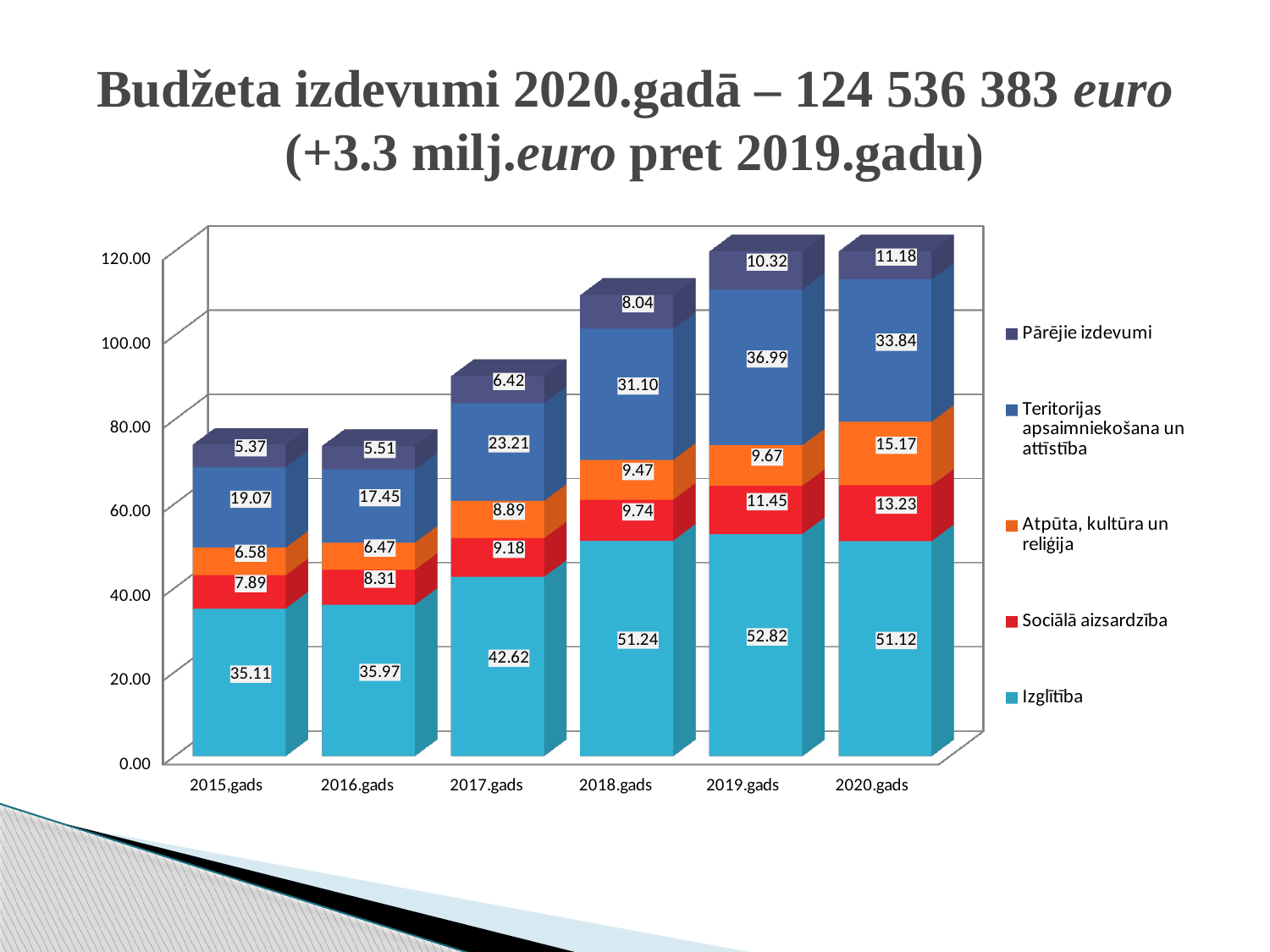
What is the total of the stacked bar for 2017.gads? 90.32 What kind of chart is shown on the slide? Stacked bar chart What is the value for Izglītība in 2018.gads? 51.24 What is the value for Atpūta, kultūra un reliģija in 2020.gads? 15.17 Does the Teritorijas apsaimniekošana un attīstība value rise or fall from 2016.gads to 2019.gads? Rise In which year is the Izglītība value highest? 2019.gads What is the value for Teritorijas apsaimniekošana un attīstība in 2019.gads? 36.99 In which year is the Pārējie izdevumi value lowest? 2015.gads What is the difference between the Sociālā aizsardzība values for 2020.gads and 2019.gads? 1.78 Which is larger: Teritorijas apsaimniekošana un attīstība in 2018.gads or in 2020.gads? 2020.gads How many series does the legend list? 5 How many years are shown on the x axis? 6